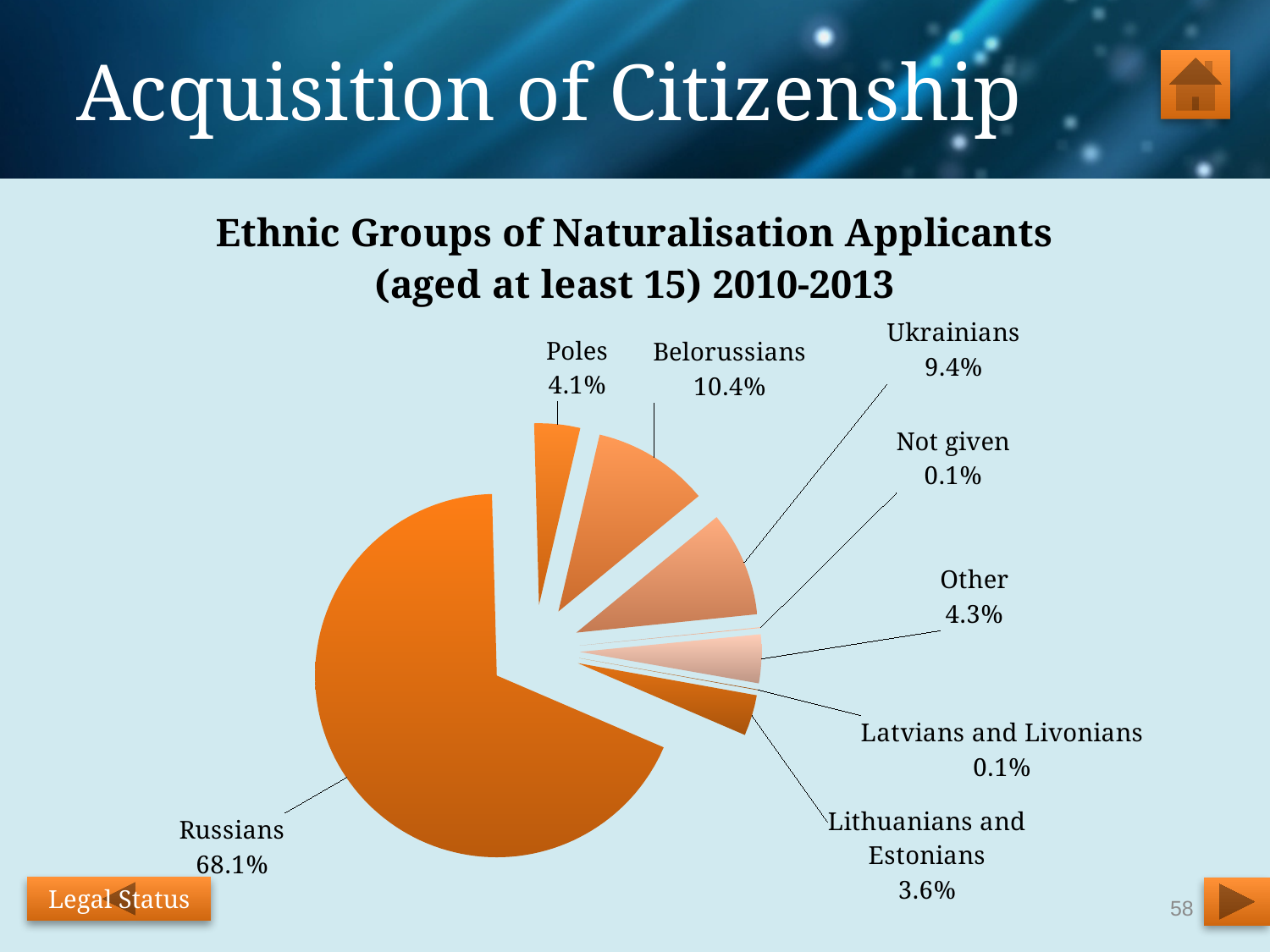
What is the difference between the Belorussians and Ukrainians shares? 1.0% What is the title of the chart? Ethnic Groups of Naturalisation Applicants (aged at least 15) 2010-2013 How many slices does the pie chart have? 8 What percentage of applicants are Ukrainians? 9.4% What percentage is shown for Latvians and Livonians? 0.1% What percentage of applicants are Lithuanians and Estonians? 3.6% Which ethnic group has the largest share of the pie? Russians Which is larger, the share for Poles or the share for Other? Other What percentage of applicants are Belorussians? 10.4% What kind of chart is shown on the slide? pie chart What is the difference between the Russians share and the Belorussians share? 57.7% What share of naturalisation applicants are Russians? 68.1%